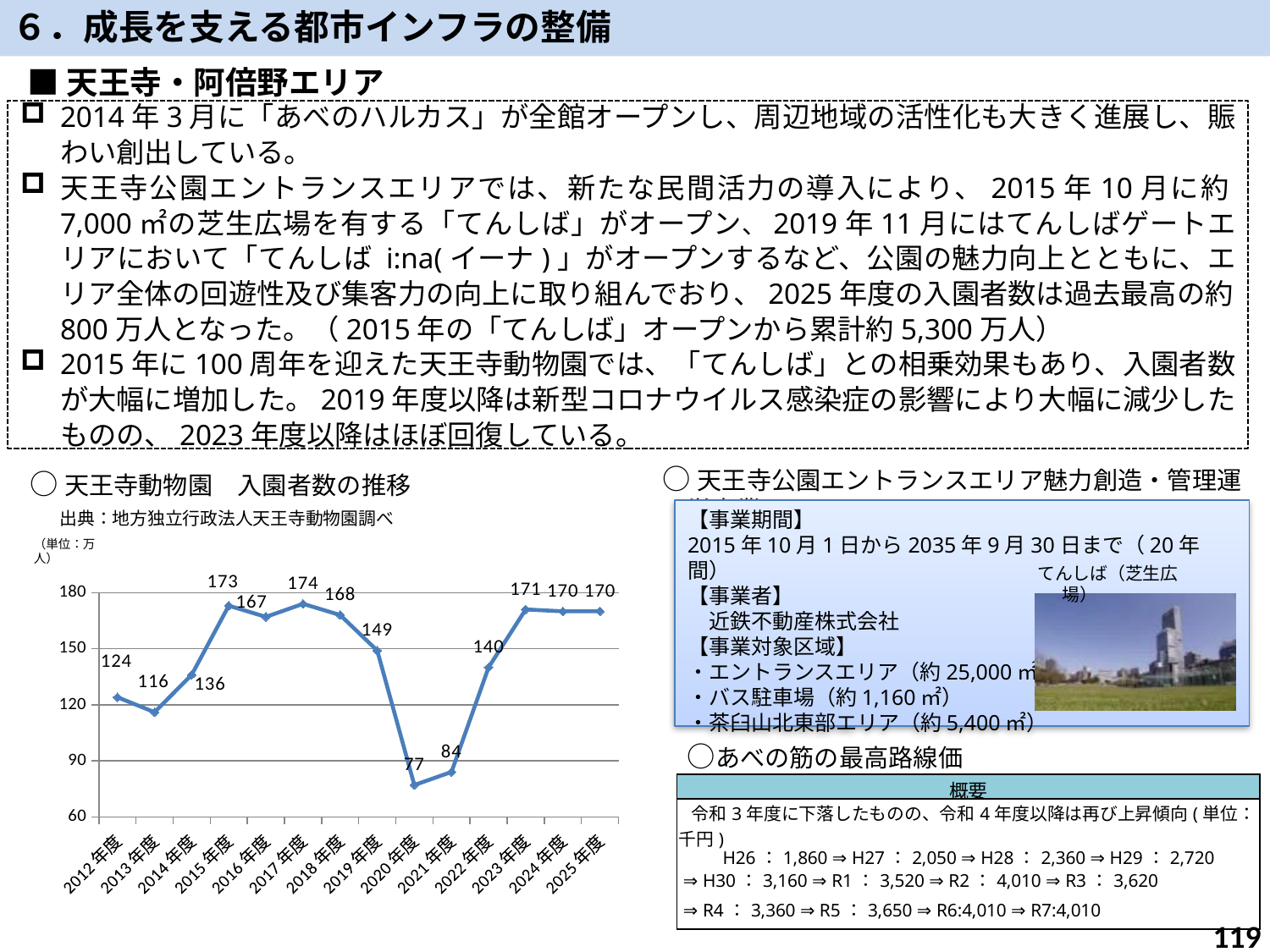
In the 天王寺動物園 入園者数の推移 chart, what is the value for 2012年度? 124 In the 天王寺動物園 入園者数の推移 chart, which fiscal year has the highest value? 2017年度 In the 天王寺動物園 入園者数の推移 chart, what is the value for 2020年度? 77 In the 天王寺動物園 入園者数の推移 chart, do the values rise or fall from 2020年度 to 2023年度? rise What unit is shown for the values in the 天王寺動物園 入園者数の推移 chart? 万人 How many fiscal years are plotted in the 天王寺動物園 入園者数の推移 chart? 14 In the 天王寺動物園 入園者数の推移 chart, what is the value for 2022年度? 140 In the 天王寺動物園 入園者数の推移 chart, is the value for 2021年度 greater or less than 90? less What type of chart is used to show 天王寺動物園 入園者数の推移? line chart In the 天王寺動物園 入園者数の推移 chart, which is larger, the value for 2013年度 or the value for 2014年度? 2014年度 In the 天王寺動物園 入園者数の推移 chart, what is the difference between the values for 2019年度 and 2020年度? 72 In the 天王寺動物園 入園者数の推移 chart, which fiscal year has the lowest value? 2020年度